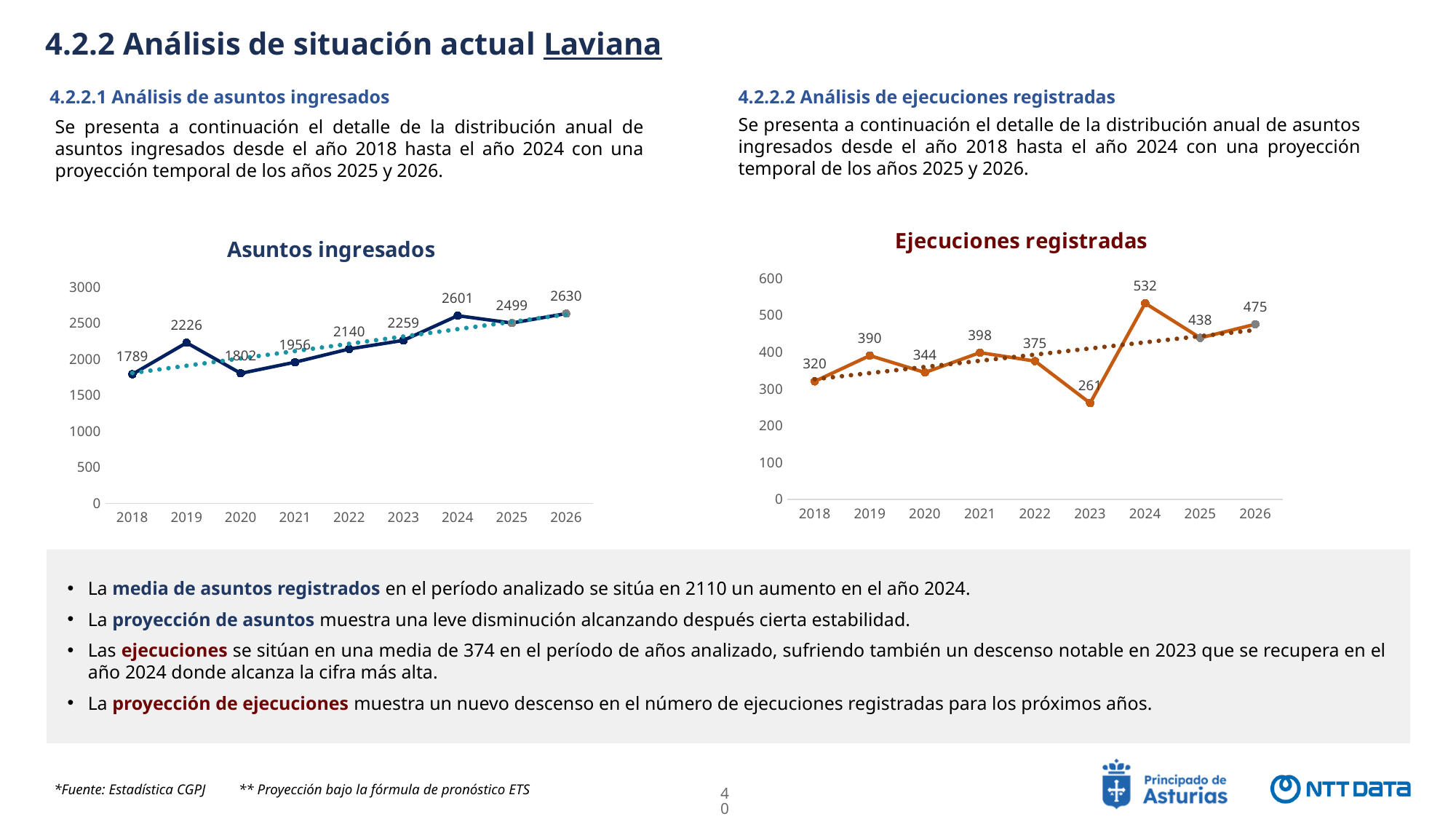
In the 'Ejecuciones registradas' chart, what is the value for 2023? 261 In the 'Asuntos ingresados' chart, what is the value for 2024? 2601 What kind of chart is 'Asuntos ingresados'? Line chart In the 'Ejecuciones registradas' chart, is the value for 2026 greater or less than 500? less In the 'Asuntos ingresados' chart, which year has the lowest value? 2018 In the 'Ejecuciones registradas' chart, which year has the highest value? 2024 In the 'Ejecuciones registradas' chart, which is larger, the value for 2019 or the value for 2021? 2021 In the 'Ejecuciones registradas' chart, what is the difference between the values for 2024 and 2023? 271 In the 'Ejecuciones registradas' chart, does the value rise or fall from 2022 to 2023? Fall In the 'Asuntos ingresados' chart, what is the value for 2019? 2226 In the 'Asuntos ingresados' chart, what is the difference between the values for 2024 and 2025? 102 In the 'Asuntos ingresados' chart, how many years are shown on the x axis? 9